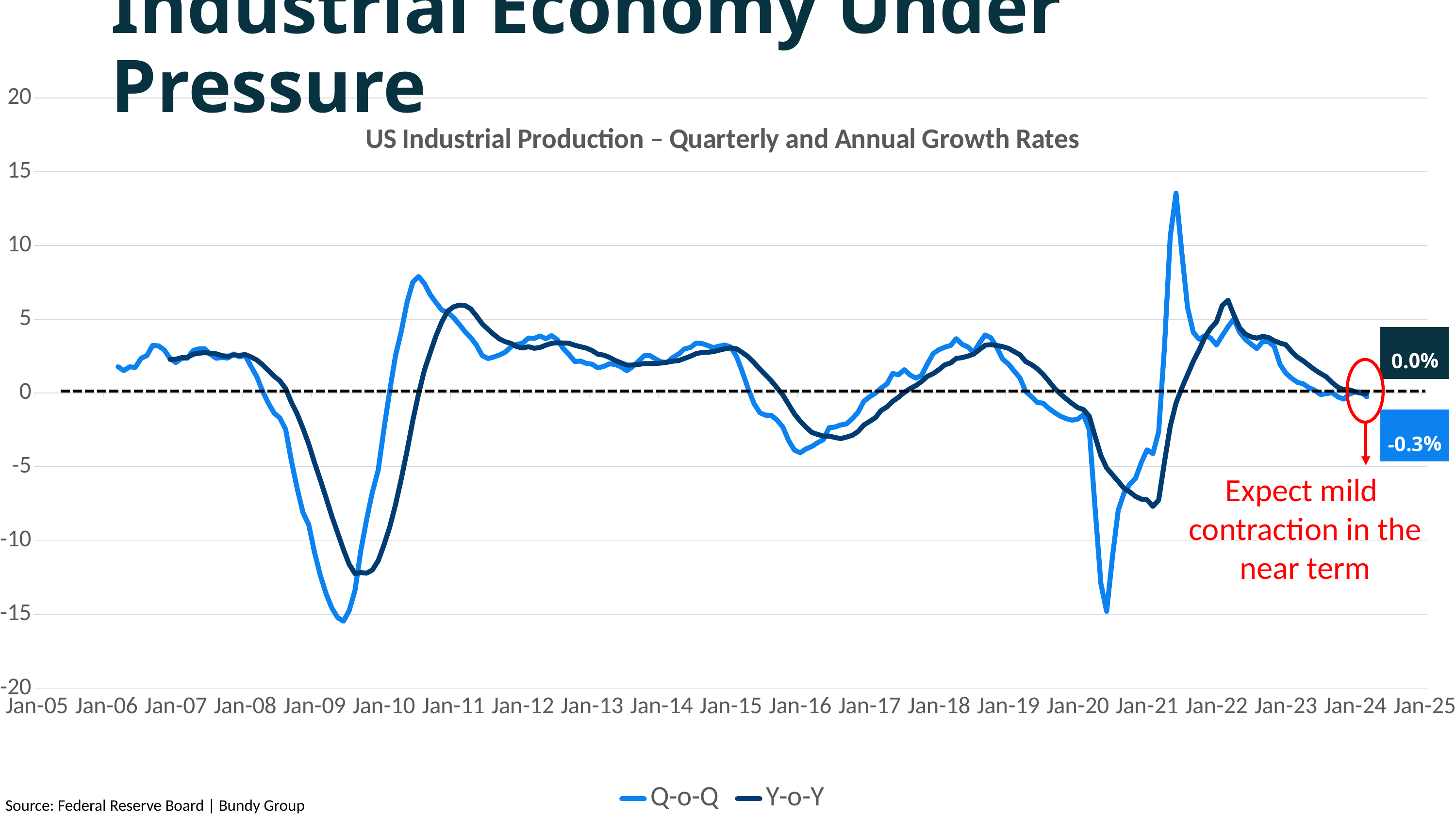
Which series reaches the lowest point on the chart? Q-o-Q Which series reaches the highest peak on the chart? Q-o-Q How many series does the legend list? 2 What are the two series named in the legend? Q-o-Q and Y-o-Y Is the peak of the Q-o-Q line near Jan-21 greater or less than 10? greater What is the latest labelled value for the Q-o-Q series? -0.3% What is the difference between the latest labelled Y-o-Y value (0.0%) and the latest labelled Q-o-Q value (-0.3%)? 0.3% What kind of chart is shown on the slide? line chart At the latest labelled point, which series has the larger value, Q-o-Q or Y-o-Y? Y-o-Y What is the title of the chart? US Industrial Production – Quarterly and Annual Growth Rates Is the lowest point of the Y-o-Y line, around 2009, greater or less than -10? less What is the latest labelled value for the Y-o-Y series? 0.0%